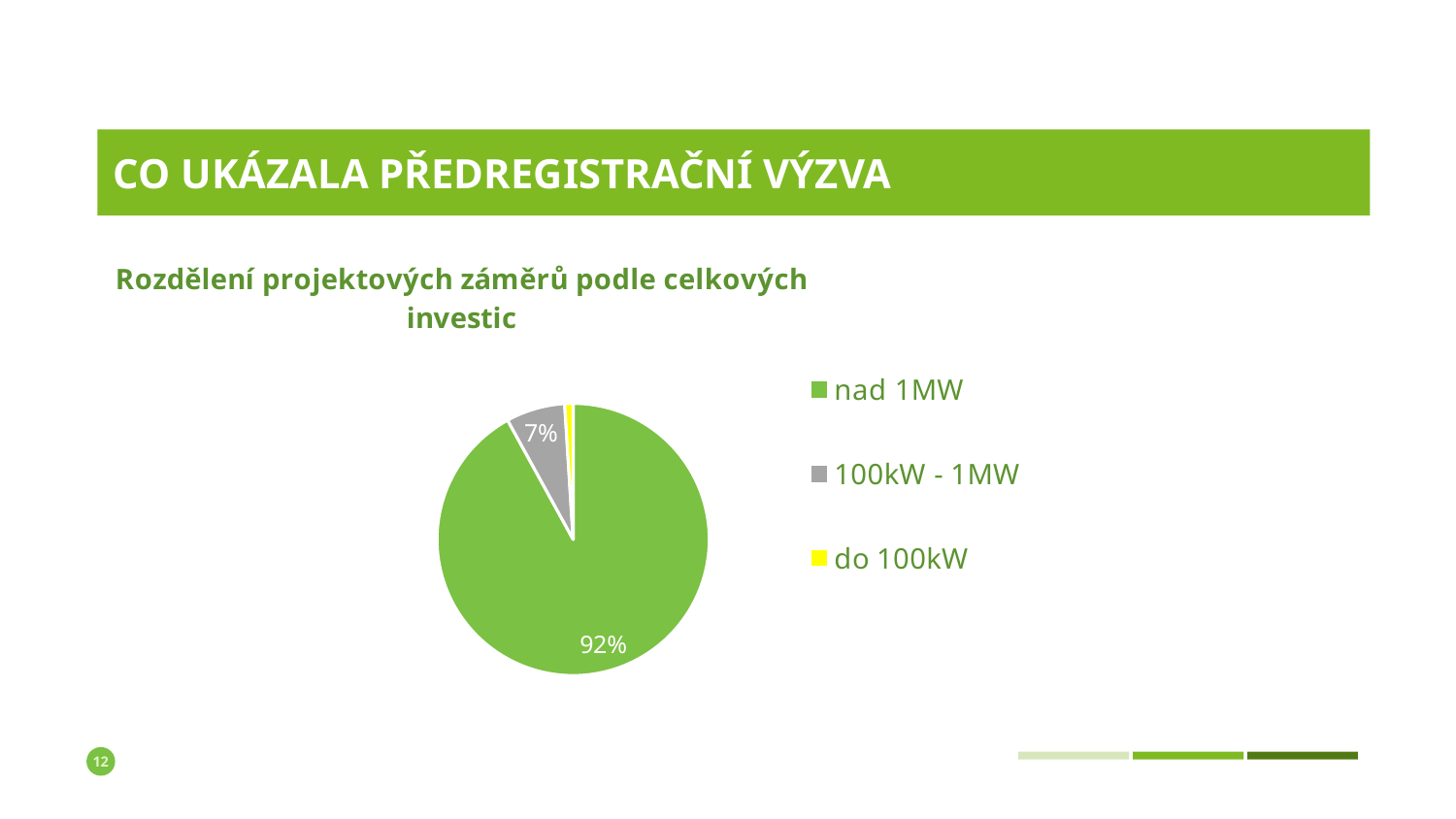
What share of the pie does the '100kW - 1MW' slice represent? 7% What kind of chart is shown on the slide? Pie chart Which slice is larger: '100kW - 1MW' or 'do 100kW'? 100kW - 1MW How many entries does the legend list? 3 What colour represents the 'do 100kW' category in the chart? Yellow Which category has the largest slice of the pie? nad 1MW By how many percentage points is the 'nad 1MW' slice larger than the '100kW - 1MW' slice? 85 percentage points How many categories are shown in the pie chart? 3 What is the title of the chart? Rozdělení projektových záměrů podle celkových investic Which category has the smallest slice of the pie? do 100kW What share of the pie does the 'nad 1MW' slice represent? 92%